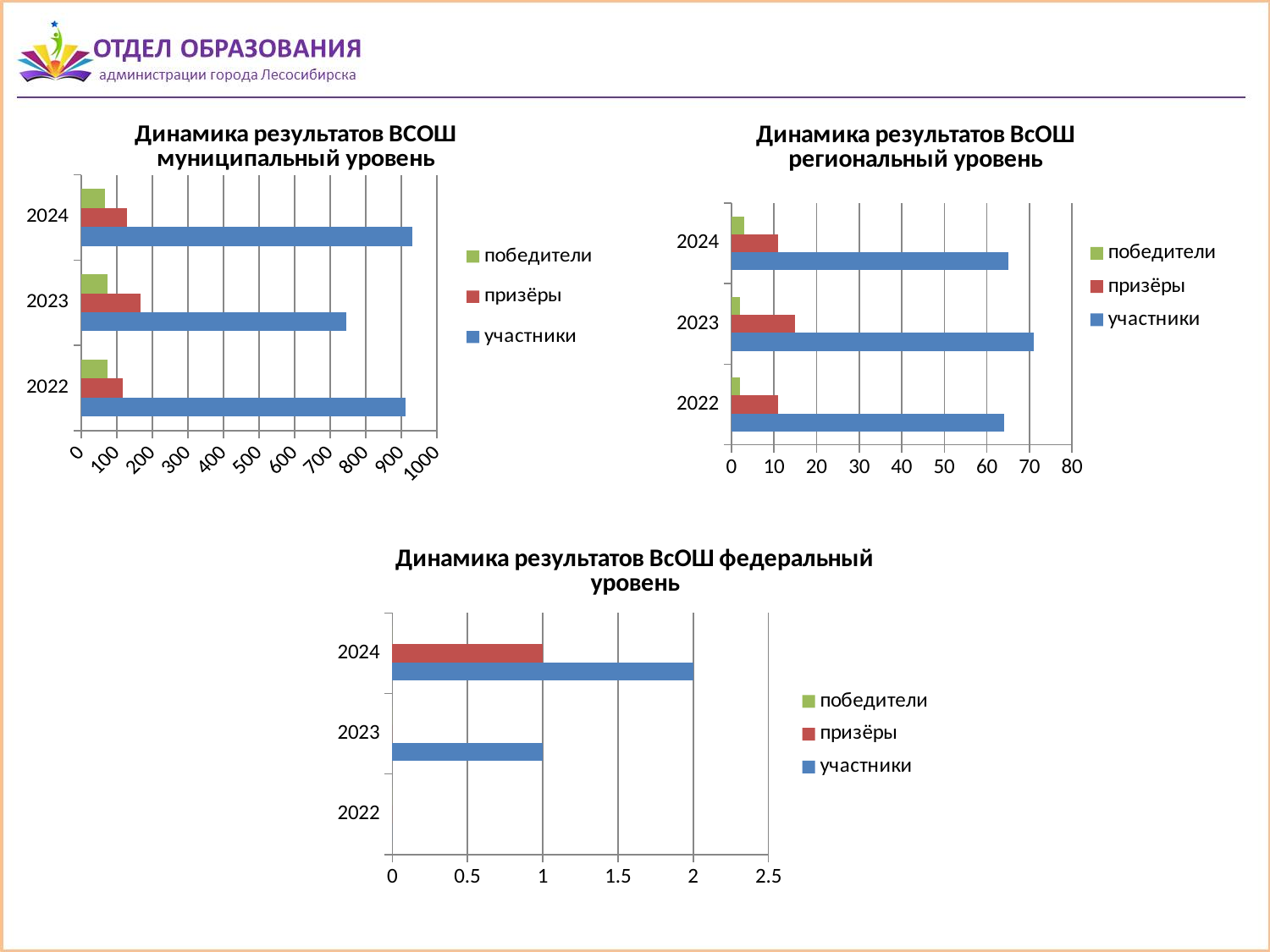
On the chart titled 'Динамика результатов ВсОШ федеральный уровень', what is the value for участники in 2023? 1 On the chart titled 'Динамика результатов ВсОШ региональный уровень', which year has the highest value for участники? 2023 On the chart titled 'Динамика результатов ВсОШ федеральный уровень', which year has the highest value for участники? 2024 On the chart titled 'Динамика результатов ВСОШ муниципальный уровень', which is larger: призёры in 2023 or призёры in 2024? призёры in 2023 On the chart titled 'Динамика результатов ВсОШ федеральный уровень', what is the value for призёры in 2024? 1 How many series does the legend list on the chart titled 'Динамика результатов ВсОШ региональный уровень'? 3 On the chart titled 'Динамика результатов ВсОШ федеральный уровень', what is the value for участники in 2024? 2 On the chart titled 'Динамика результатов ВСОШ муниципальный уровень', is the value for участники in 2023 greater or less than 800? less On the chart titled 'Динамика результатов ВСОШ муниципальный уровень', is the value for участники in 2024 greater or less than 900? greater On the chart titled 'Динамика результатов ВСОШ муниципальный уровень', which year has the lowest value for участники? 2023 What kind of chart is the chart titled 'Динамика результатов ВСОШ муниципальный уровень'? bar chart